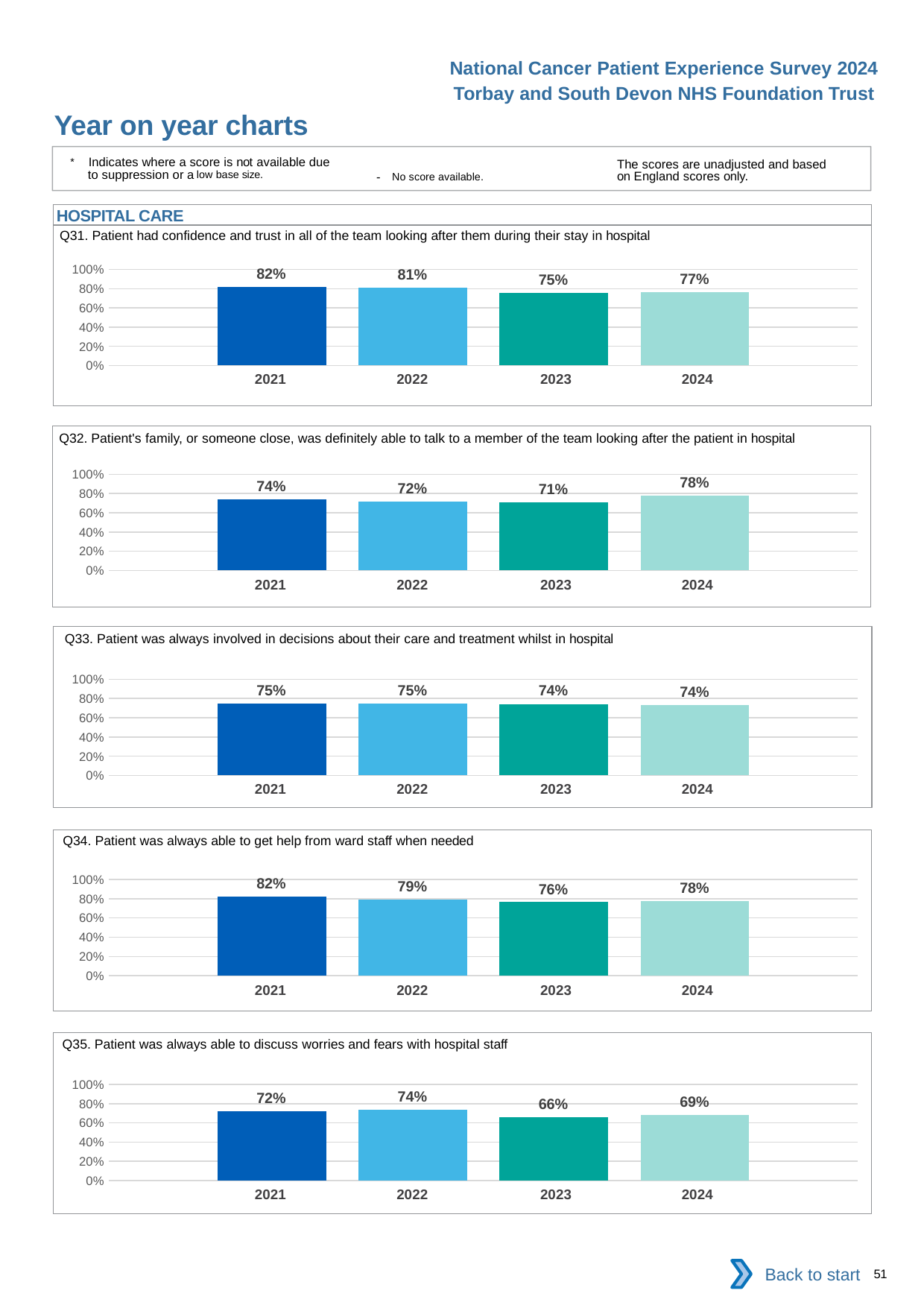
In the Q34 chart, what is the value for 2022? 79% In the Q34 chart, is the value for 2021 larger or smaller than the value for 2024? larger In the Q33 chart, what is the value for 2024? 74% In the Q35 chart, which year has the lowest value? 2023 What type of chart is the Q31 chart? Bar chart In the Q31 chart, what is the value for 2021? 82% In the Q33 chart, how many years are plotted? 4 In the Q32 chart, which year has the highest value? 2024 In the Q35 chart, what is the difference between the 2022 and 2021 values? 2 percentage points In the Q31 chart, which year has the lowest value? 2023 In the Q32 chart, what is the difference between the 2024 and 2023 values? 7 percentage points In the Q34 chart, do the values rise or fall from 2021 to 2023? Fall